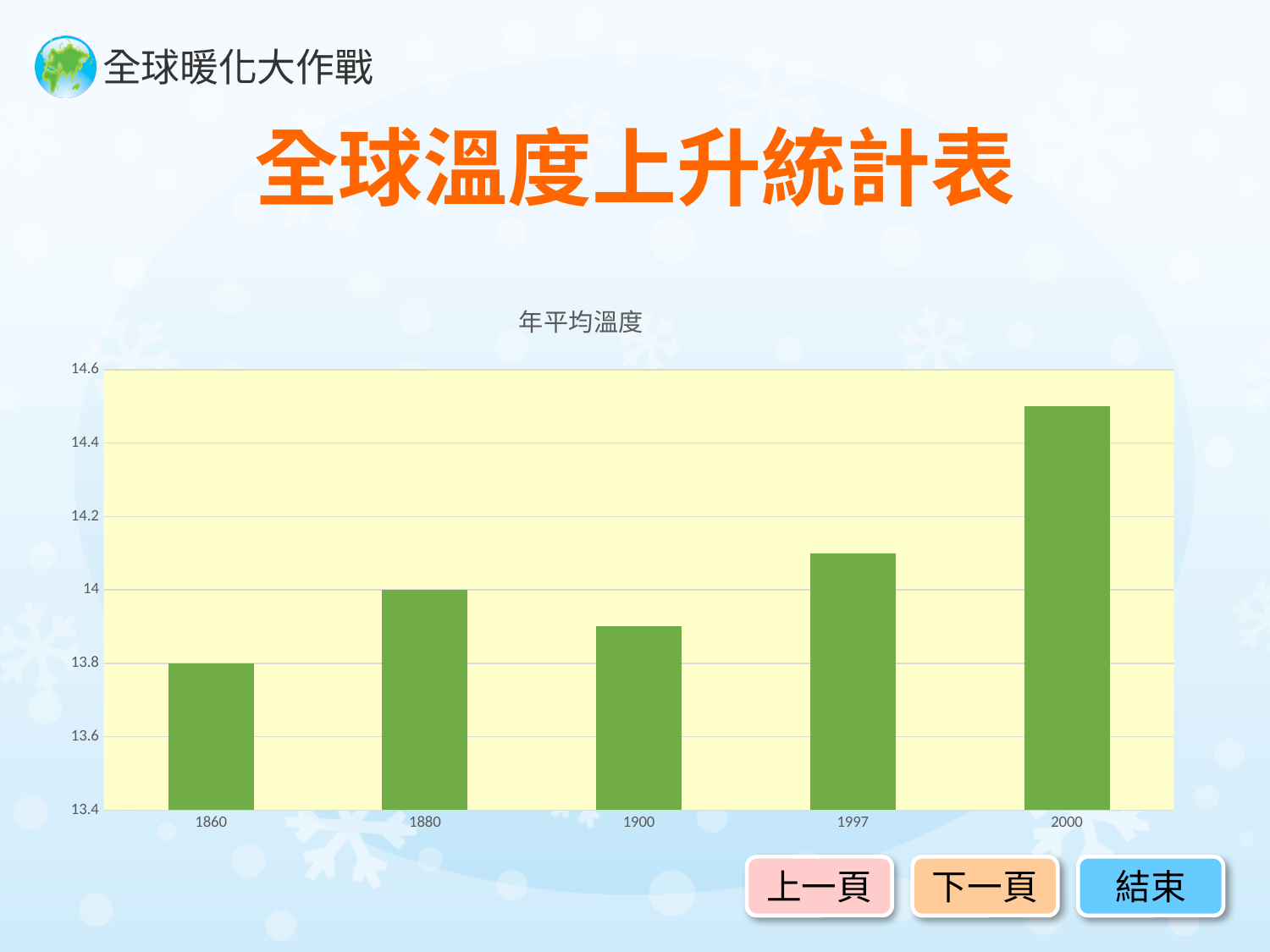
Which year has the highest 年平均溫度? 2000 Is the value for 1900 greater or less than 14? less Is the value for 1997 greater or less than 14? greater What is the 年平均溫度 value for 1880? 14 What is the title of the chart? 年平均溫度 What kind of chart is shown on the slide? bar chart Is the value for 2000 greater or less than 14.4? greater Which year has a higher value, 1880 or 1900? 1880 What is the difference between the values for 1880 and 1860? 0.2 Which year has the lowest 年平均溫度? 1860 What is the 年平均溫度 value for 1860? 13.8 How many years are shown on the x axis of the chart? 5